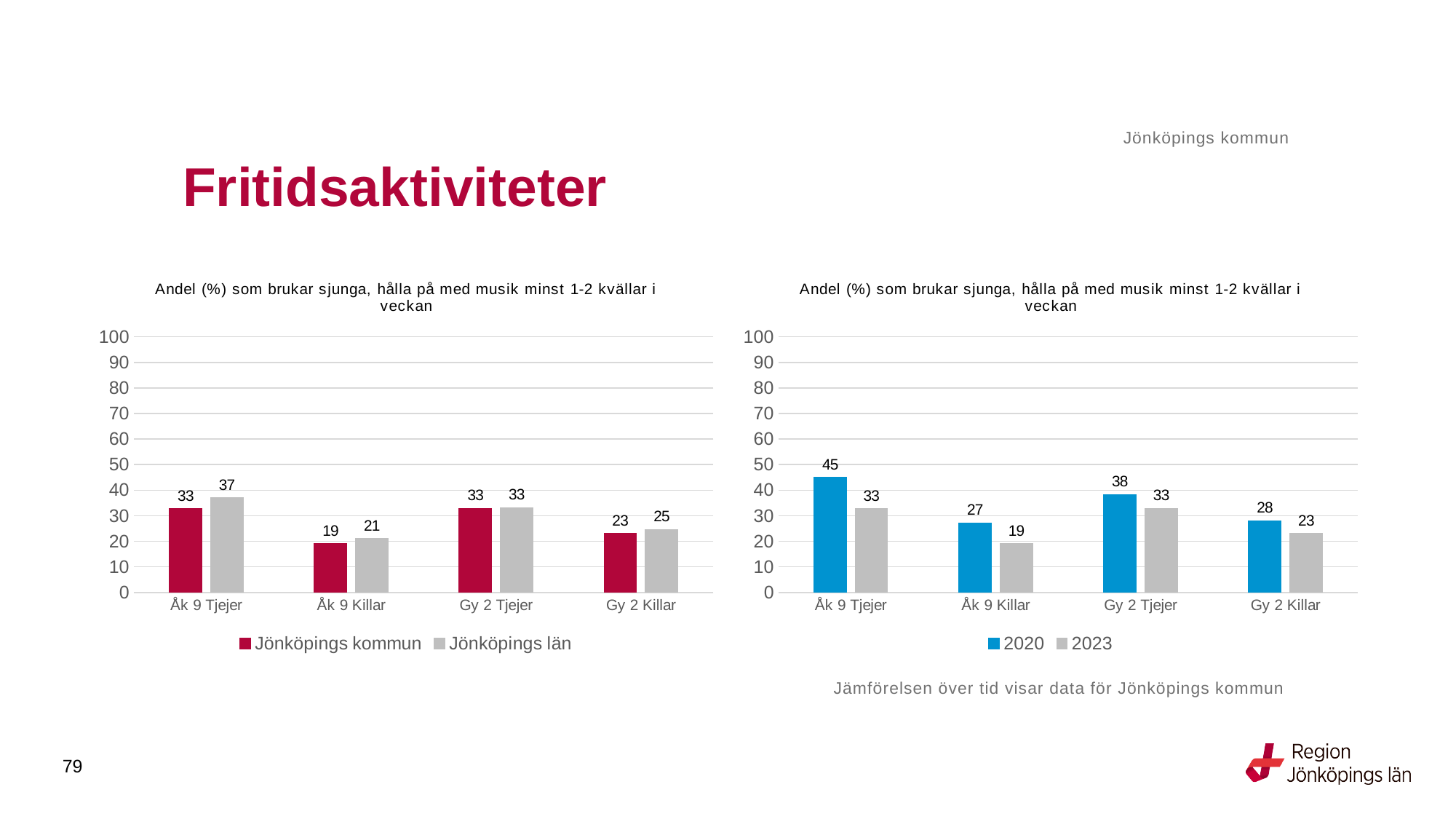
How many categories are shown on the x axis of the right chart? 4 In the right chart, what is the value for 2023 for Gy 2 Killar? 23 What kind of chart is the left chart? Bar chart In the right chart, what is the difference between 2020 and 2023 for Åk 9 Tjejer? 12 In the left chart, what is the value for Jönköpings kommun for Åk 9 Tjejer? 33 In the left chart, which category has the lowest value for Jönköpings kommun? Åk 9 Killar In the left chart, what is the difference between Jönköpings län and Jönköpings kommun for Åk 9 Tjejer? 4 In the left chart, how many series does the legend list? 2 In the right chart, which is larger for Gy 2 Tjejer: 2020 or 2023? 2020 In the left chart, what is the value for Jönköpings län for Gy 2 Killar? 25 In the right chart, what is the value for 2020 for Åk 9 Tjejer? 45 In the right chart, which category has the highest value for 2020? Åk 9 Tjejer